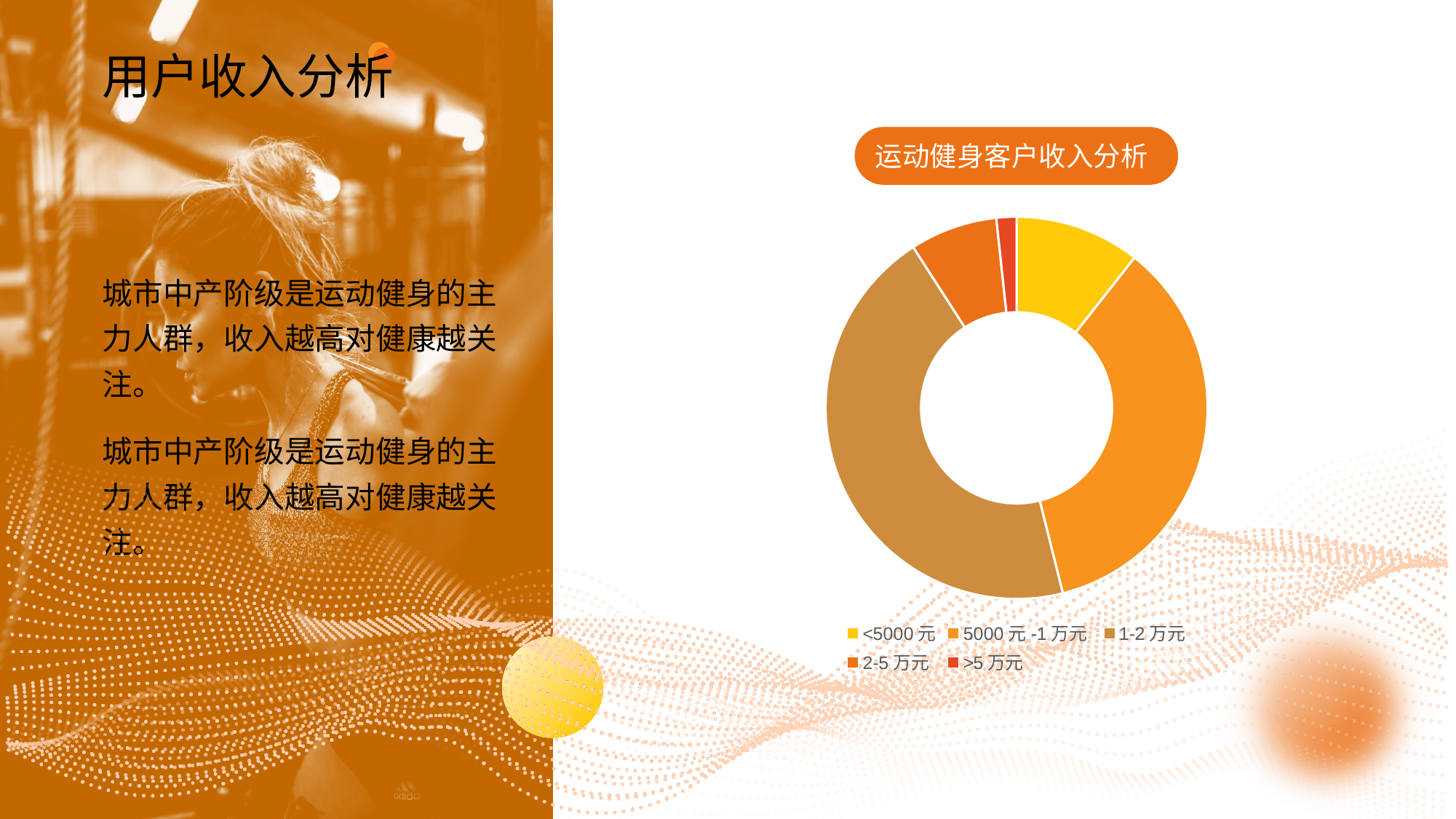
How many income categories does the chart show? 5 Which is larger, the share for <5000 元 or the share for >5 万元? <5000 元 Which income category has the smallest share of the chart? >5 万元 Which is larger, the share for 5000 元 -1 万元 or the share for 2-5 万元? 5000 元 -1 万元 What kind of chart is shown on the slide? Donut (pie) chart Which income category has the largest share of the chart? 1-2 万元 What is the title of the chart? 运动健身客户收入分析 Which colour represents the <5000 元 category in the legend? Yellow Which is larger, the share for 1-2 万元 or the share for 5000 元 -1 万元? 1-2 万元 How many entries does the legend list? 5